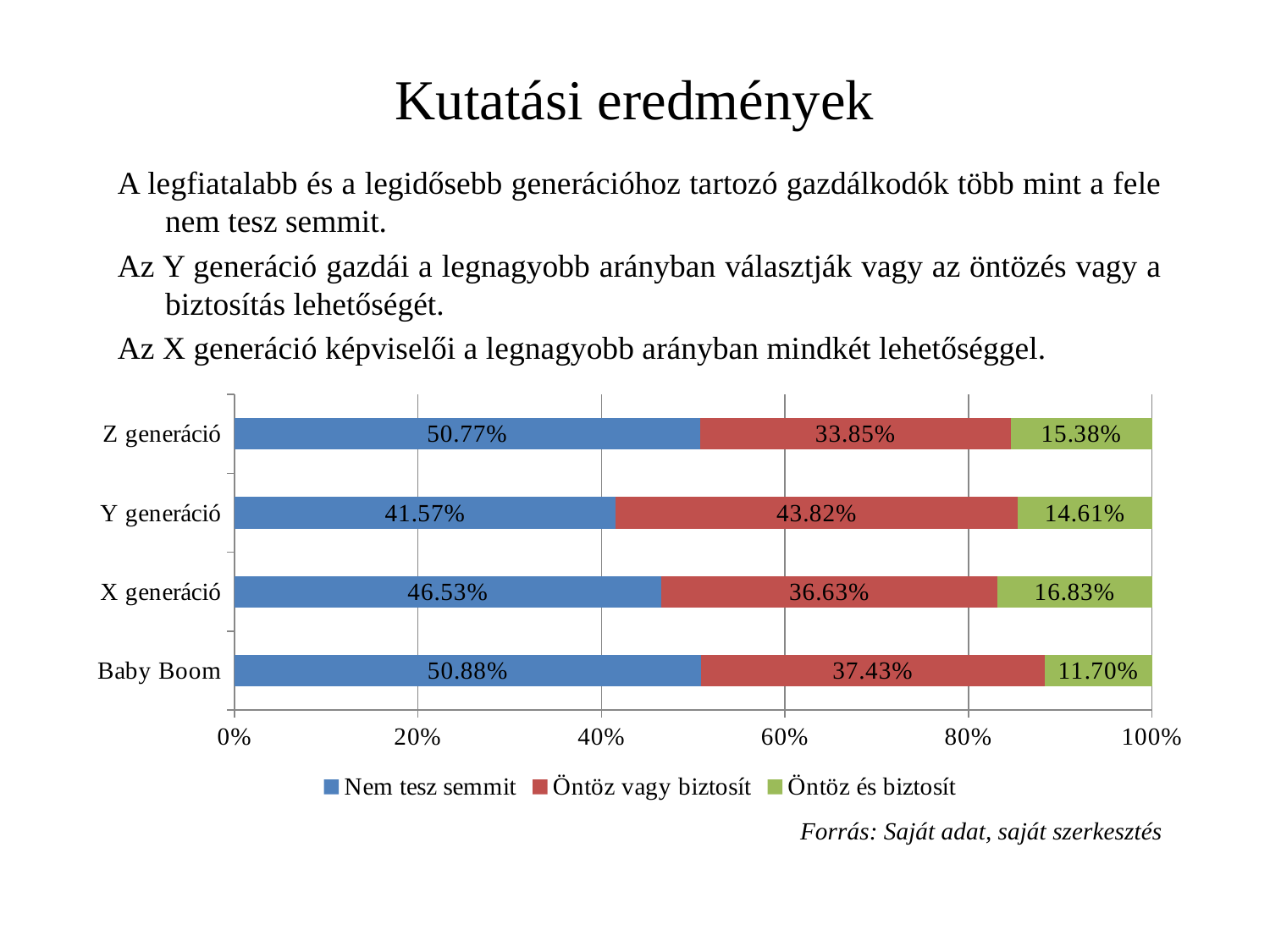
What is the value of "Öntöz vagy biztosít" for Y generáció? 43.82% What is the difference between the "Öntöz vagy biztosít" values for Y generáció and Z generáció? 9.97% How many series does the legend list? 3 What is the value of "Nem tesz semmit" for Z generáció? 50.77% Which generation has the lowest value for "Nem tesz semmit"? Y generáció Which is larger: the "Nem tesz semmit" value for Z generáció or for Y generáció? Z generáció Which generation has the highest value for "Öntöz és biztosít"? X generáció How many generation categories are shown in the chart? 4 What kind of chart is shown on the slide? Stacked bar chart What colour represents "Öntöz és biztosít" in the legend? Green What is the value of "Öntöz és biztosít" for Baby Boom? 11.70% Which generation has the highest value for "Öntöz vagy biztosít"? Y generáció